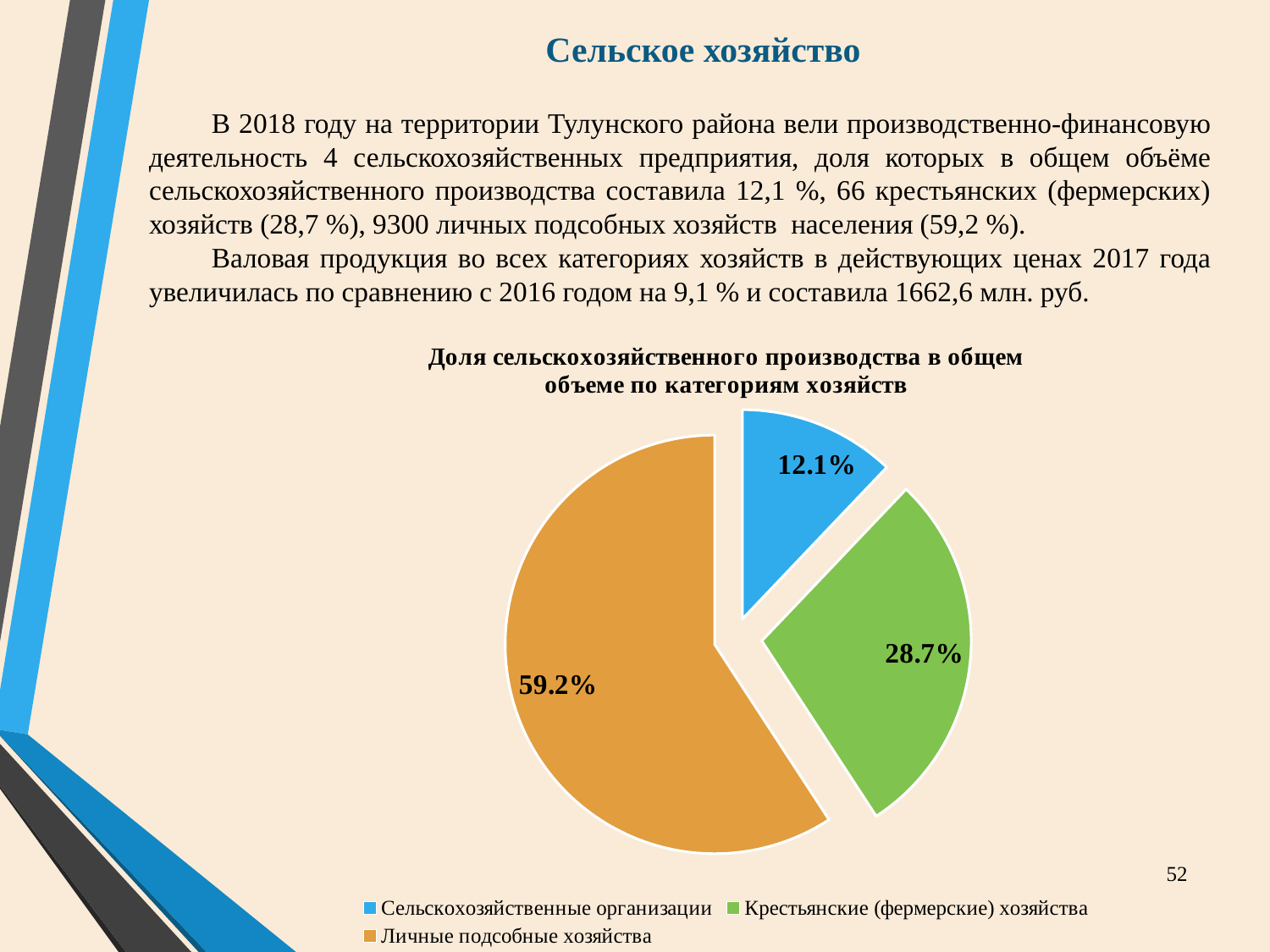
What is the share for Крестьянские (фермерские) хозяйства? 28.7% Which category has the smallest share of the pie? Сельскохозяйственные организации How many slices does the pie chart have? 3 What is the share for Личные подсобные хозяйства? 59.2% How many entries does the legend list? 3 What type of chart is shown on the slide? pie chart Which category has the largest share of the pie? Личные подсобные хозяйства What is the difference in percentage points between Личные подсобные хозяйства and Крестьянские (фермерские) хозяйства? 30.5 Which is larger: the share for Крестьянские (фермерские) хозяйства or the share for Сельскохозяйственные организации? Крестьянские (фермерские) хозяйства What is the share for Сельскохозяйственные организации? 12.1% What colour is the slice for Личные подсобные хозяйства? orange What is the title of the chart? Доля сельскохозяйственного производства в общем объеме по категориям хозяйств